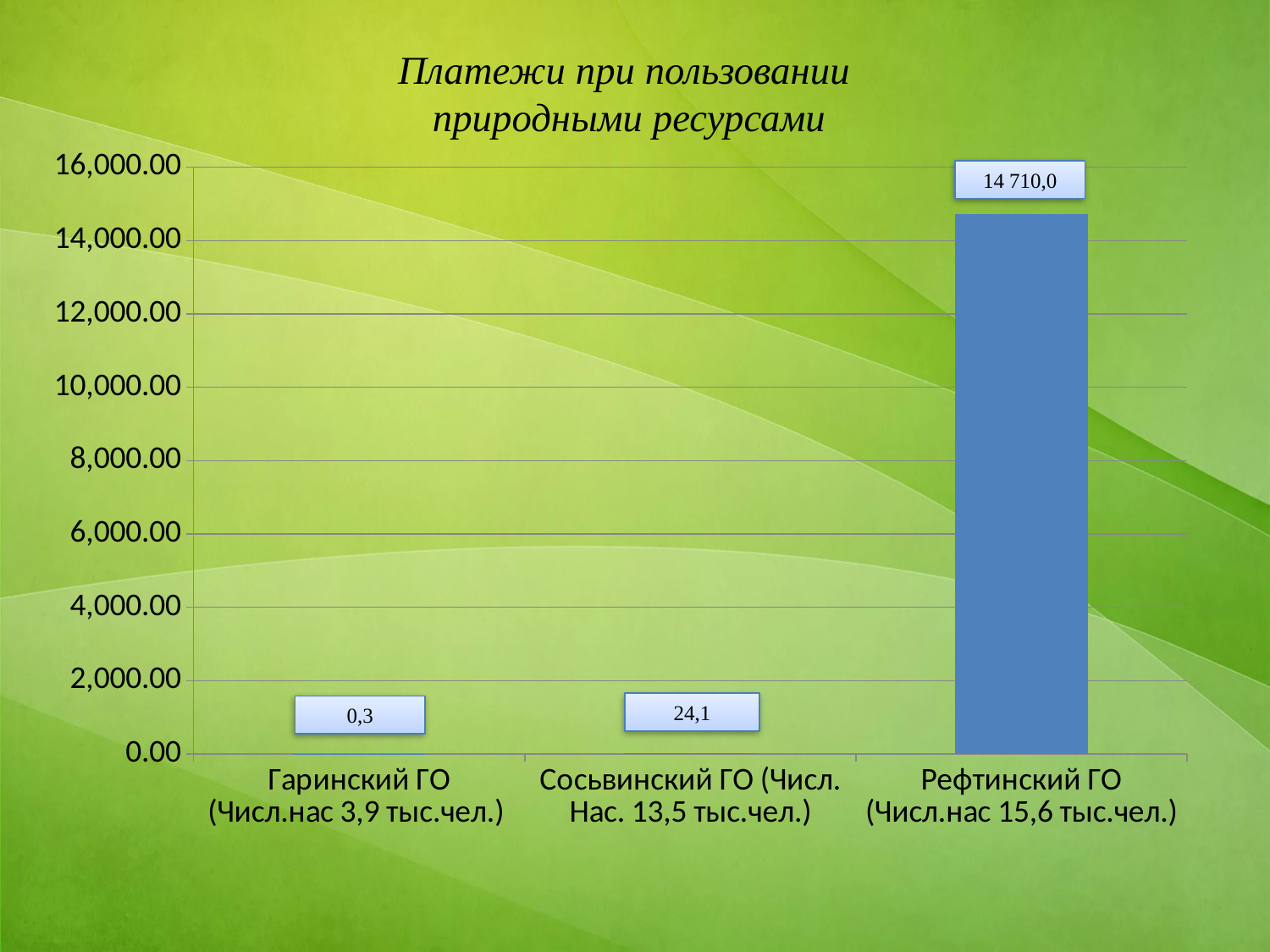
What is the value for Сосьвинский ГО? 24,1 What is the value for Гаринский ГО? 0,3 How many categories are shown on the chart? 3 What is the value for Рефтинский ГО? 14 710,0 What is the title of the chart? Платежи при пользовании природными ресурсами What is the difference between the values for Сосьвинский ГО and Гаринский ГО? 23,8 What kind of chart is shown on the slide? bar chart Which category has the lowest value? Гаринский ГО Which is larger, the value for Сосьвинский ГО or the value for Гаринский ГО? Сосьвинский ГО Is the value for Рефтинский ГО greater or less than 14,000.00? greater What is the difference between the values for Рефтинский ГО and Сосьвинский ГО? 14 685,9 Which category has the highest value? Рефтинский ГО